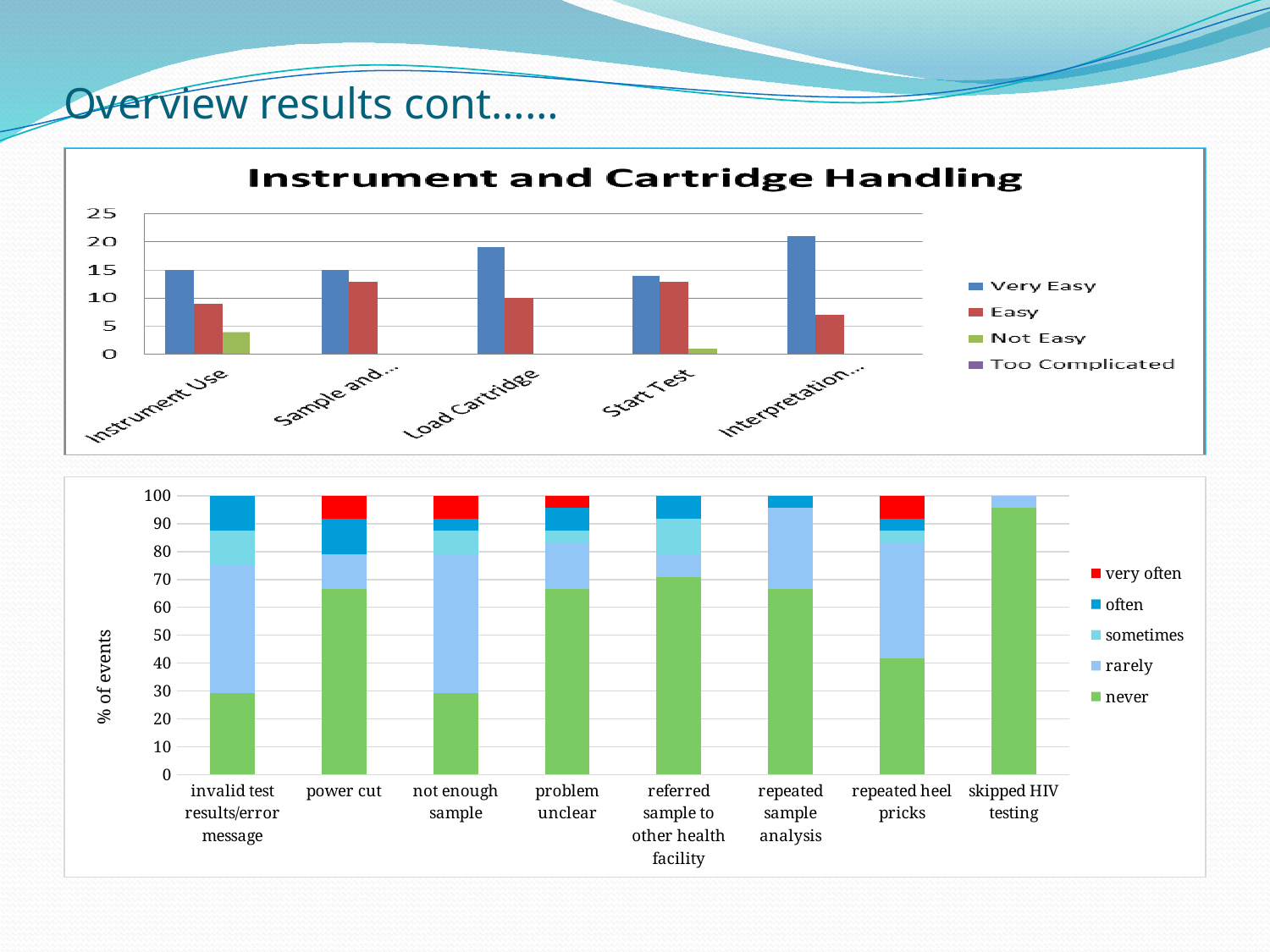
How many series does the legend of the top chart 'Instrument and Cartridge Handling' list? 4 What kind of chart is the bottom chart on the slide? stacked bar chart In the bottom chart, is the 'never' value for skipped HIV testing greater or less than 90? greater How many categories are shown on the x axis of the top chart 'Instrument and Cartridge Handling'? 5 What is the y-axis label of the bottom chart? % of events In the top chart 'Instrument and Cartridge Handling', which is larger for Load Cartridge: Very Easy or Easy? Very Easy How many categories are shown on the x axis of the bottom chart? 8 What kind of chart is the top chart titled 'Instrument and Cartridge Handling'? bar chart In the top chart 'Instrument and Cartridge Handling', is the Easy value for Load Cartridge greater or less than 15? less In the top chart 'Instrument and Cartridge Handling', is the Very Easy value for Interpretation greater or less than 15? greater How many series does the legend of the bottom chart list? 5 In the top chart 'Instrument and Cartridge Handling', which category has the highest Very Easy value? Interpretation